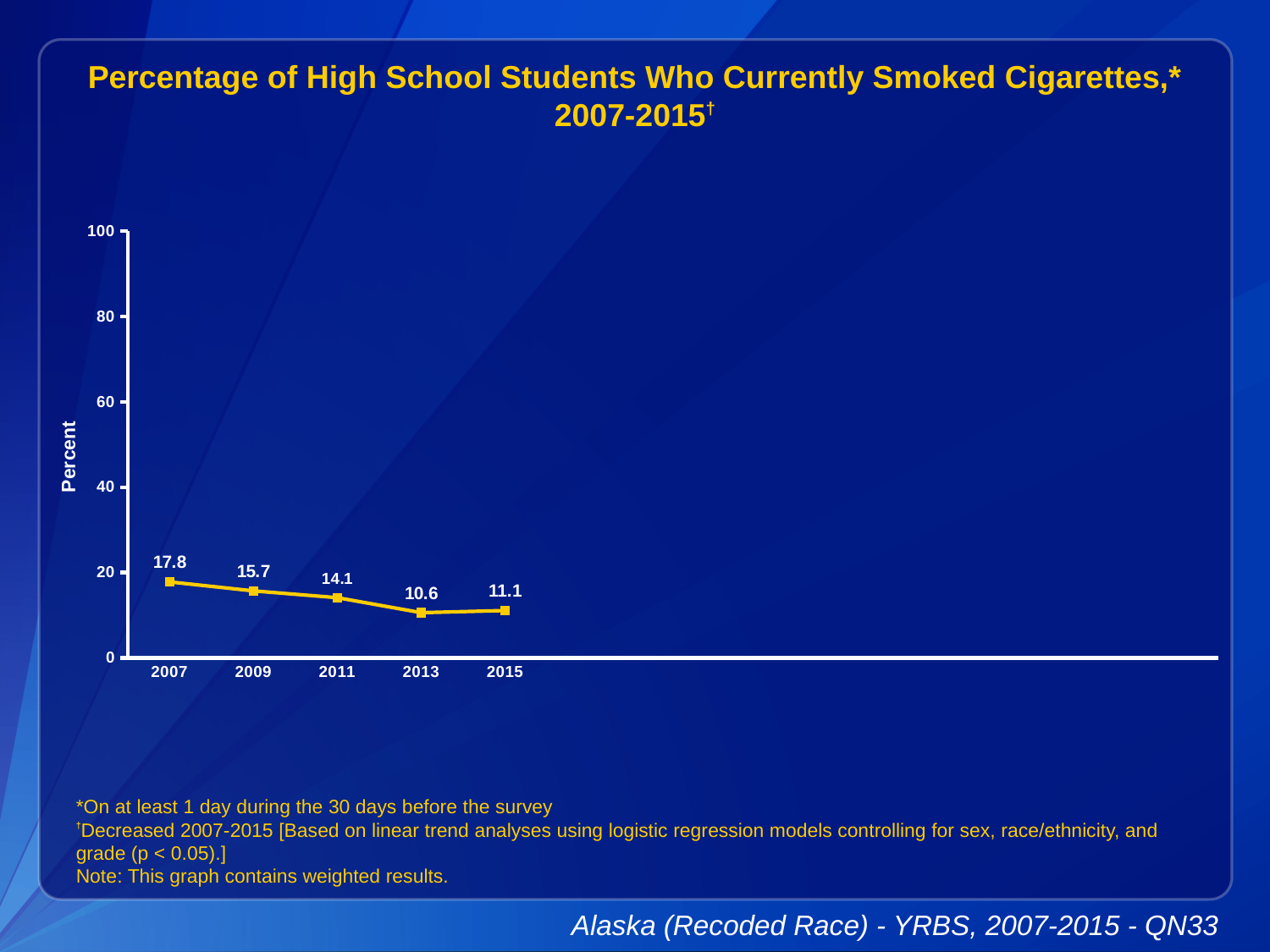
What is the label on the vertical axis? Percent What is the value plotted for 2015? 11.1 What percentage of high school students currently smoked cigarettes in 2007? 17.8 What is the difference between the 2007 value and the 2015 value? 6.7 Is the value for 2007 greater or less than 20? less Which year has the larger value, 2009 or 2013? 2009 How many years are plotted on the chart? 5 What is the value plotted for 2013? 10.6 Which year has the highest value on the chart? 2007 What is the difference between the 2009 value and the 2011 value? 1.6 Which year has the lowest value on the chart? 2013 What kind of chart is shown on the slide? line chart